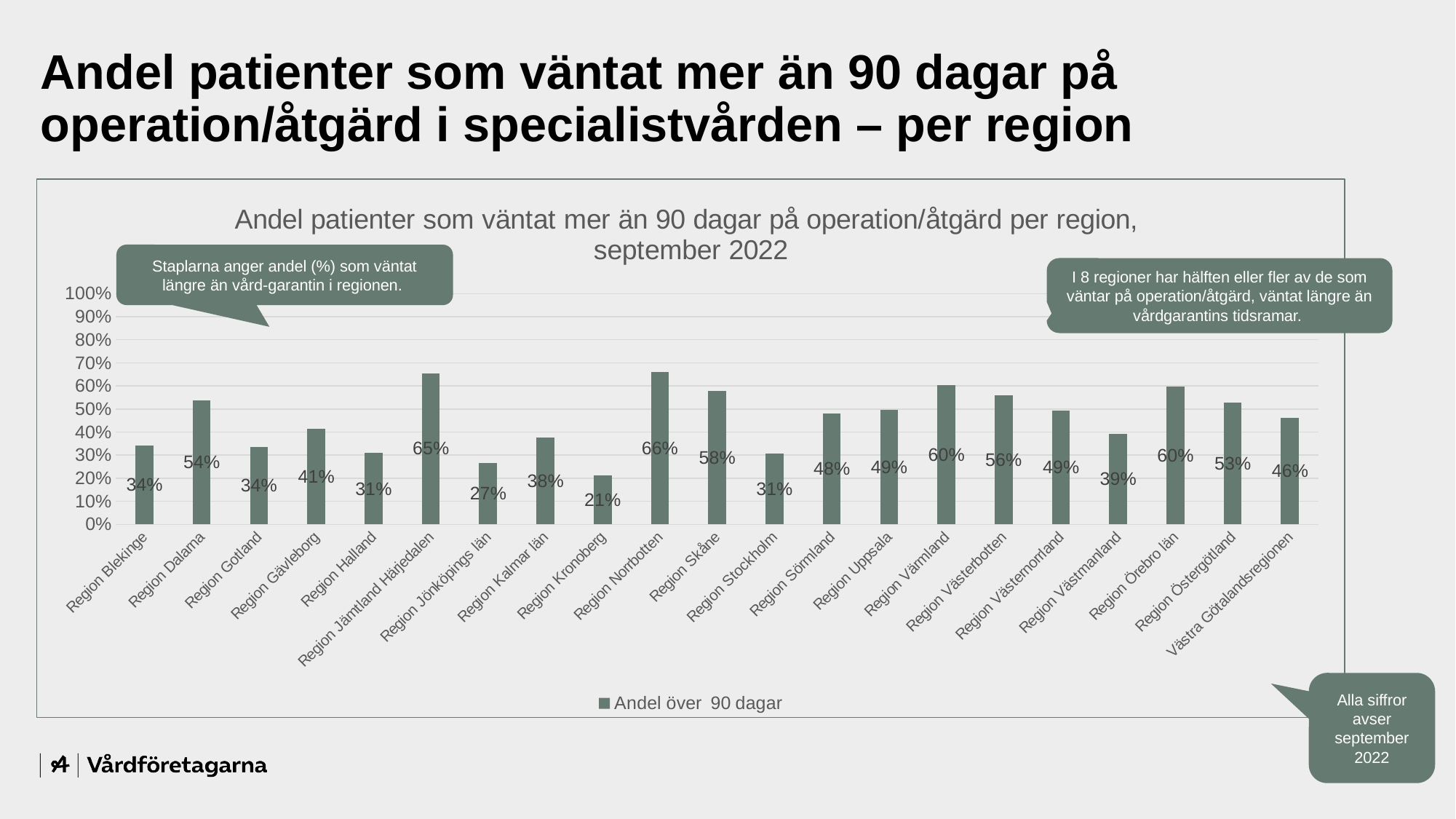
Is the value for Region Värmland greater or less than 50%? greater How many regions are shown on the x axis? 21 What is the value for Region Stockholm? 31% Which region has the lowest value? Region Kronoberg What kind of chart is shown? Bar chart What is the value for Västra Götalandsregionen? 46% What is the value for Region Jämtland Härjedalen? 65% What is the value for Region Kronoberg? 21% How many series does the legend list? 1 Which region has the highest value? Region Norrbotten What is the difference between the values for Region Skåne and Region Halland? 27% Which is larger, the value for Region Dalarna or the value for Region Gävleborg? Region Dalarna